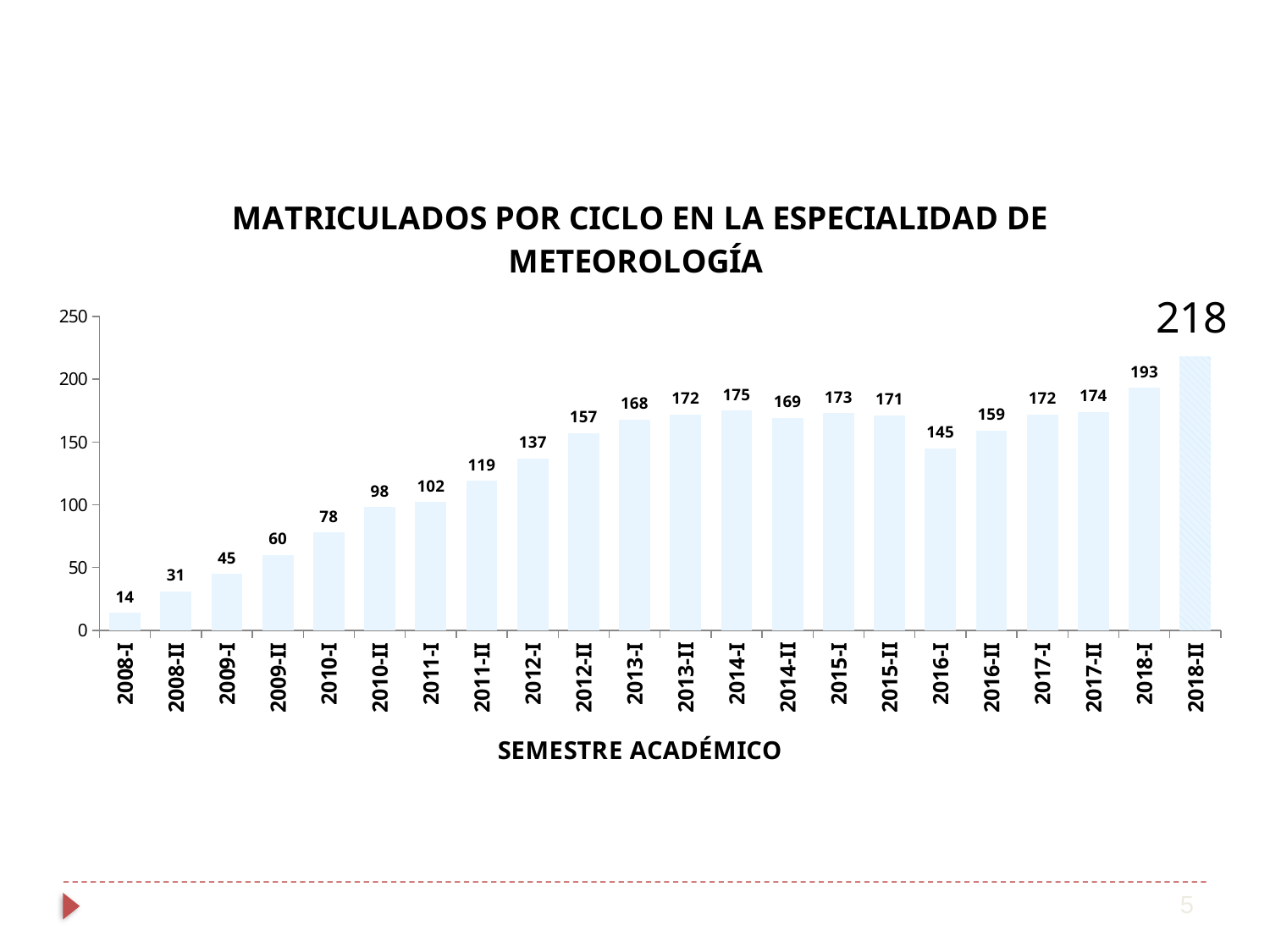
What is the value for 2012-I? 137 Which semester has the lowest number of enrolled students? 2008-I Which semester has the highest number of enrolled students? 2018-II How many semesters are shown on the x axis? 22 What is the difference between the values for 2018-II and 2018-I? 25 What is the value for 2016-I? 145 Is the value for 2011-II greater or less than 100? greater What is the value for 2018-II? 218 What kind of chart is shown on the slide? bar chart What is the difference between the values for 2014-I and 2016-I? 30 What is the x-axis title of the chart? SEMESTRE ACADÉMICO Which is larger, the value for 2015-I or the value for 2016-II? 2015-I